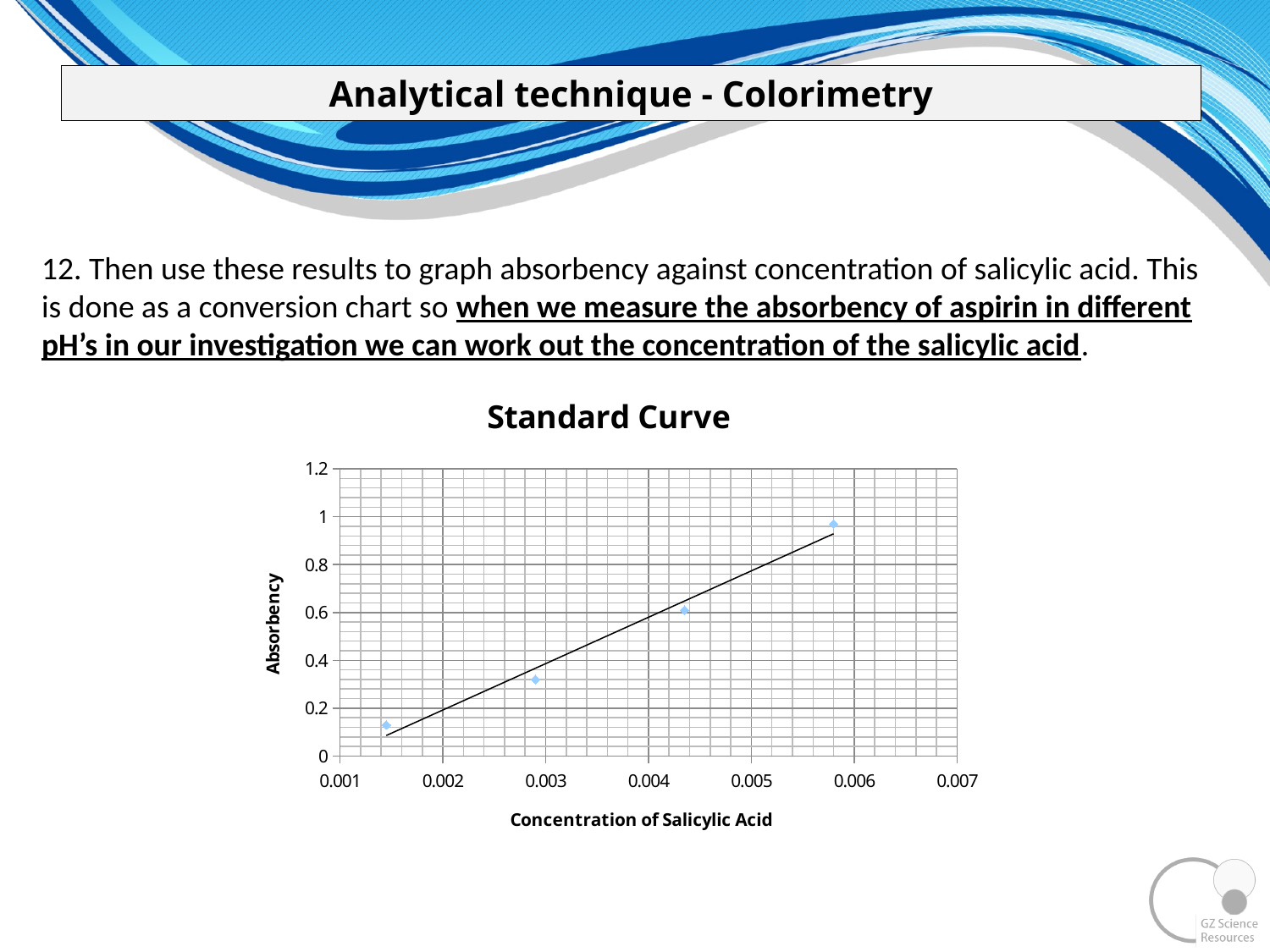
Is the absorbency of the data point nearest a concentration of 0.004 greater or less than 0.8? less Which has the larger absorbency: the data point nearest a concentration of 0.003 or the data point nearest a concentration of 0.004? the data point nearest 0.004 Which data point has the highest absorbency: the one at the lowest concentration or the one at the highest concentration? the one at the highest concentration What kind of chart is shown on the slide? scatter chart What is the title of the chart? Standard Curve Does absorbency rise or fall as the concentration of salicylic acid increases? rise Is the absorbency of the data point at the highest concentration greater or less than 0.8? greater How many data points are plotted on the chart? 4 Is the absorbency of the data point at the lowest concentration greater or less than 0.2? less Which data point has the lowest absorbency: the one at the lowest concentration or the one at the highest concentration? the one at the lowest concentration What is the label of the y axis of the chart? Absorbency